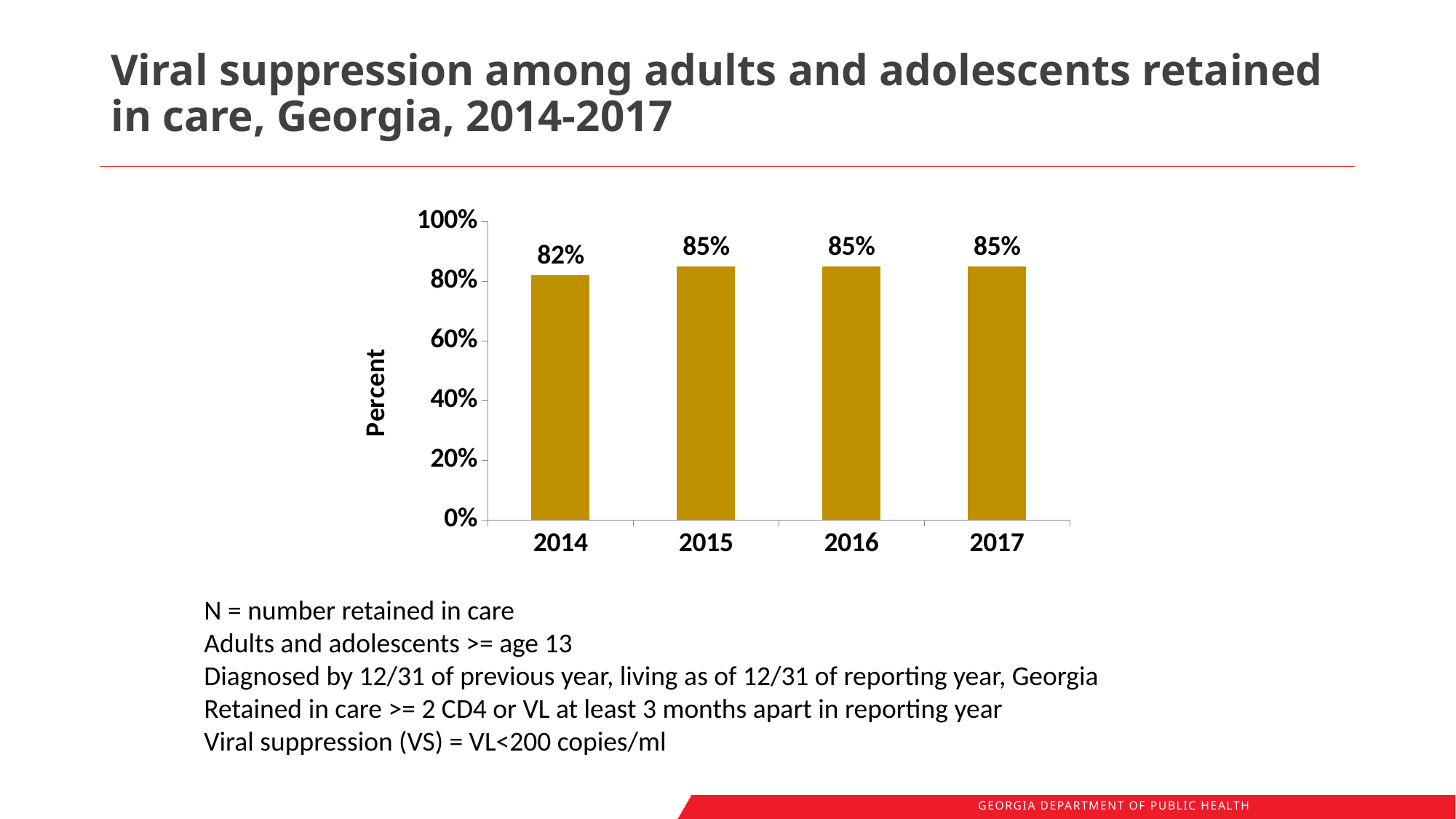
How many years are shown on the x axis? 4 What is the viral suppression percentage for 2017? 85% Which year has the lowest viral suppression percentage? 2014 Is the value for 2014 greater or less than 80%? greater Which is larger, the value for 2014 or the value for 2016? 2016 What kind of chart is shown on the slide? bar chart What is the difference in viral suppression percentage between 2015 and 2014? 3% What is the viral suppression percentage for 2015? 85% What is the viral suppression percentage for 2014? 82% Do the values rise or fall from 2014 to 2015? rise What colour are the bars in the chart? gold What is the label of the y axis? Percent